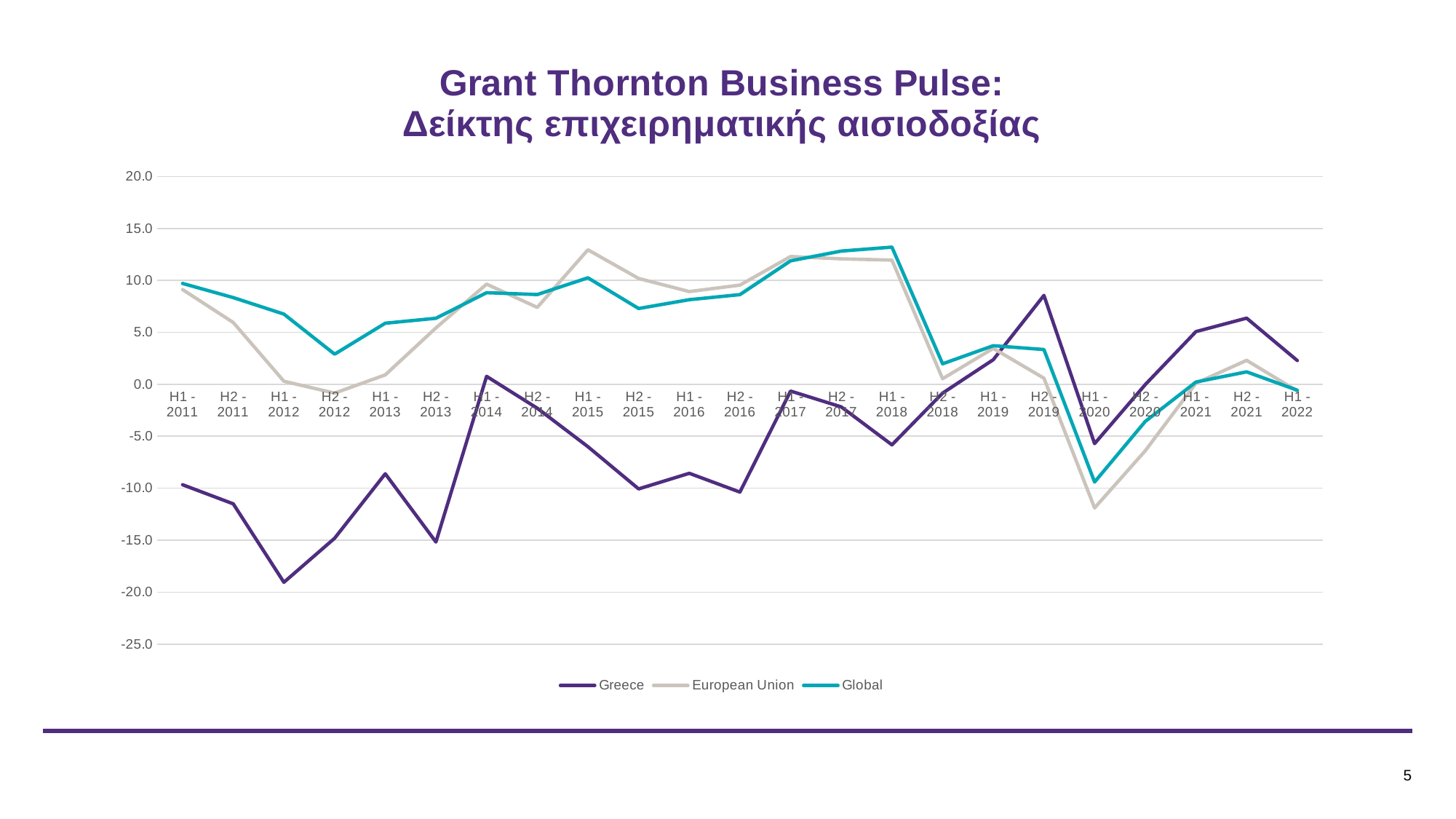
What kind of chart is shown on the slide? Line chart Is the value for European Union at H1 - 2020 greater or less than -10.0? less How many time points are plotted along the x axis? 23 Is the value for Greece at H1 - 2012 greater or less than -15.0? less Does the Greece series rise or fall from H2 - 2021 to H1 - 2022? Fall How many series does the legend list? 3 At H1 - 2011, which is larger: the value for Greece or the value for Global? Global Which series are listed in the legend? Greece, European Union, Global Is the value for Global at H1 - 2018 greater or less than 10.0? greater At which time point does the Greece series reach its highest value? H2 - 2019 At which time point does the Greece series reach its lowest value? H1 - 2012